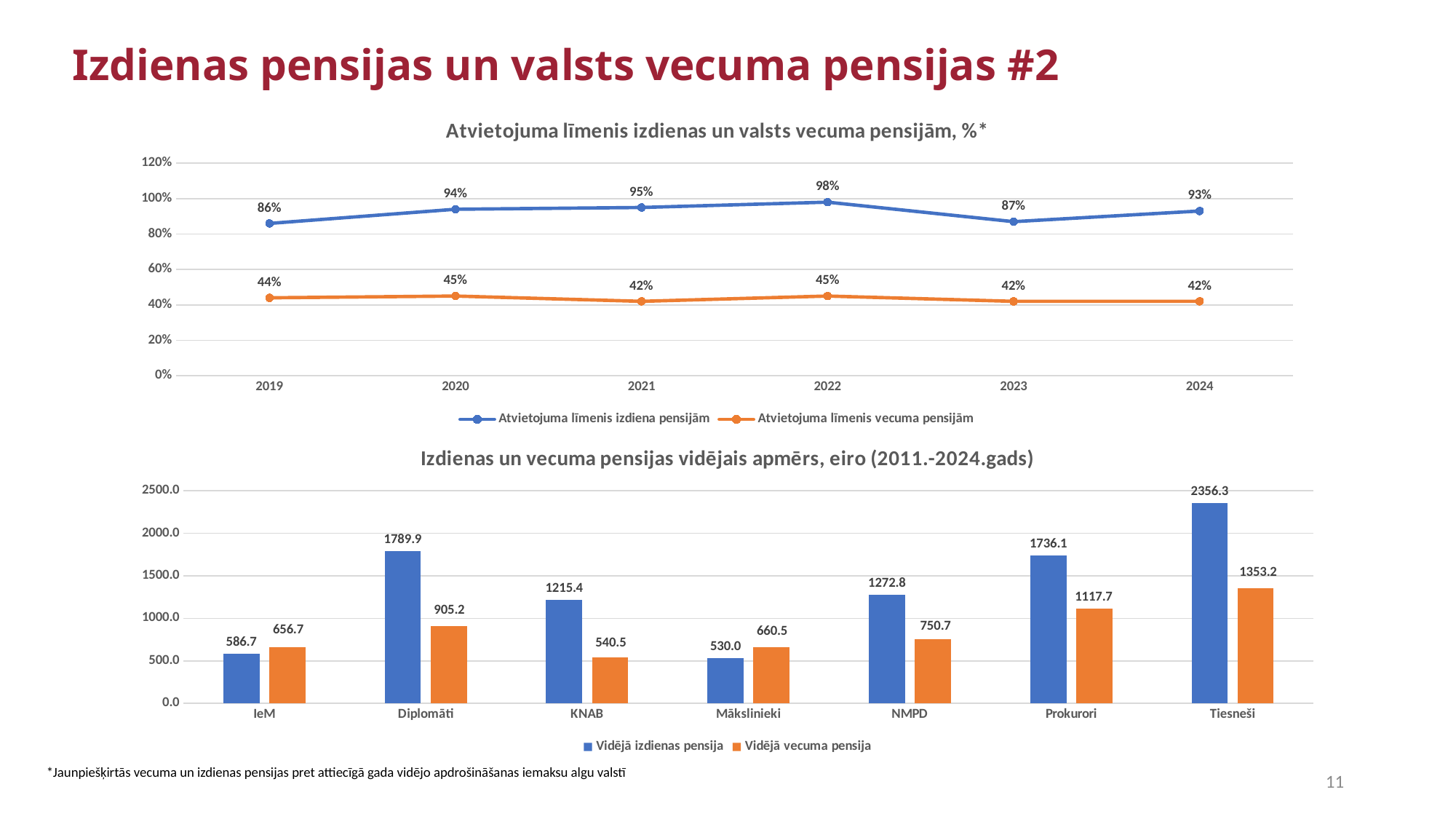
In the top chart, what kind of chart is it? line chart In the bottom chart (Izdienas un vecuma pensijas vidējais apmērs, eiro), what is the Vidējā izdienas pensija for Prokurori? 1736.1 In the top chart, how many years are shown on the x axis? 6 In the top chart, what is the difference between the two series in 2024? 51% In the bottom chart, how many series does the legend list? 2 In the bottom chart, which category has the lowest Vidējā vecuma pensija? KNAB In the bottom chart, which is larger for Mākslinieki: Vidējā izdienas pensija or Vidējā vecuma pensija? Vidējā vecuma pensija In the top chart (Atvietojuma līmenis izdienas un valsts vecuma pensijām, %), what is the value for Atvietojuma līmenis izdiena pensijām in 2022? 98% In the top chart, what is the value for Atvietojuma līmenis vecuma pensijām in 2020? 45% In the top chart, which year has the lowest value for Atvietojuma līmenis izdiena pensijām? 2019 In the bottom chart, what is the difference between Vidējā izdienas pensija and Vidējā vecuma pensija for Diplomāti? 884.7 In the bottom chart, which category has the highest Vidējā izdienas pensija? Tiesneši